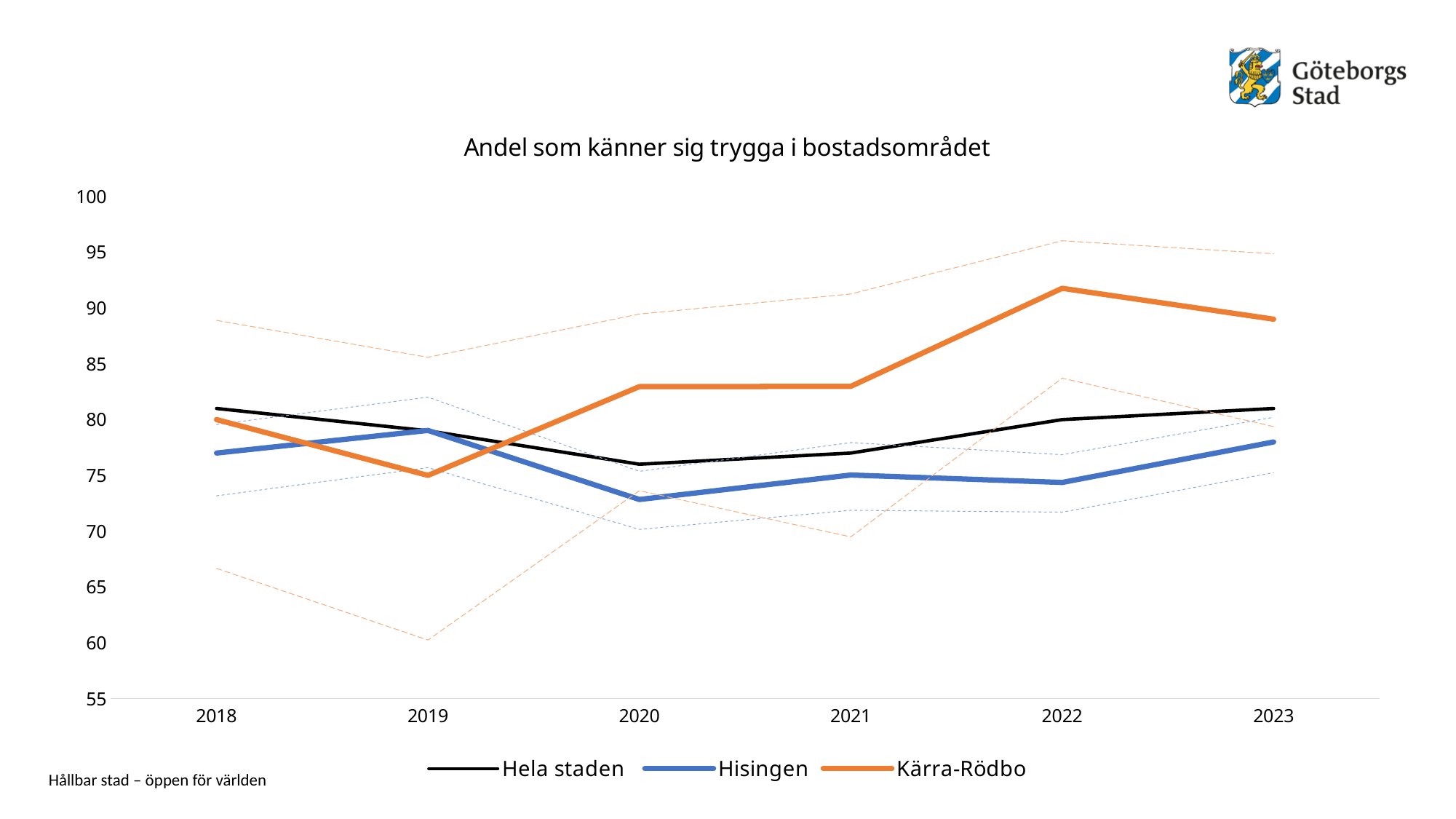
What is the title of the chart? Andel som känner sig trygga i bostadsområdet Does the Kärra-Rödbo line rise or fall from 2019 to 2022? rise How many years are shown on the x axis? 6 Which series is drawn in orange? Kärra-Rödbo What kind of chart is shown on the slide? line chart Is the value for Kärra-Rödbo in 2022 greater or less than 90? greater In 2019, which is larger: Hela staden or Kärra-Rödbo? Hela staden In which year does Kärra-Rödbo reach its highest value? 2022 Is the value for Hisingen in 2020 greater or less than 75? less Is the value for Kärra-Rödbo in 2021 greater or less than 80? greater How many series does the legend list? 3 In which year does Hisingen have its lowest value? 2020